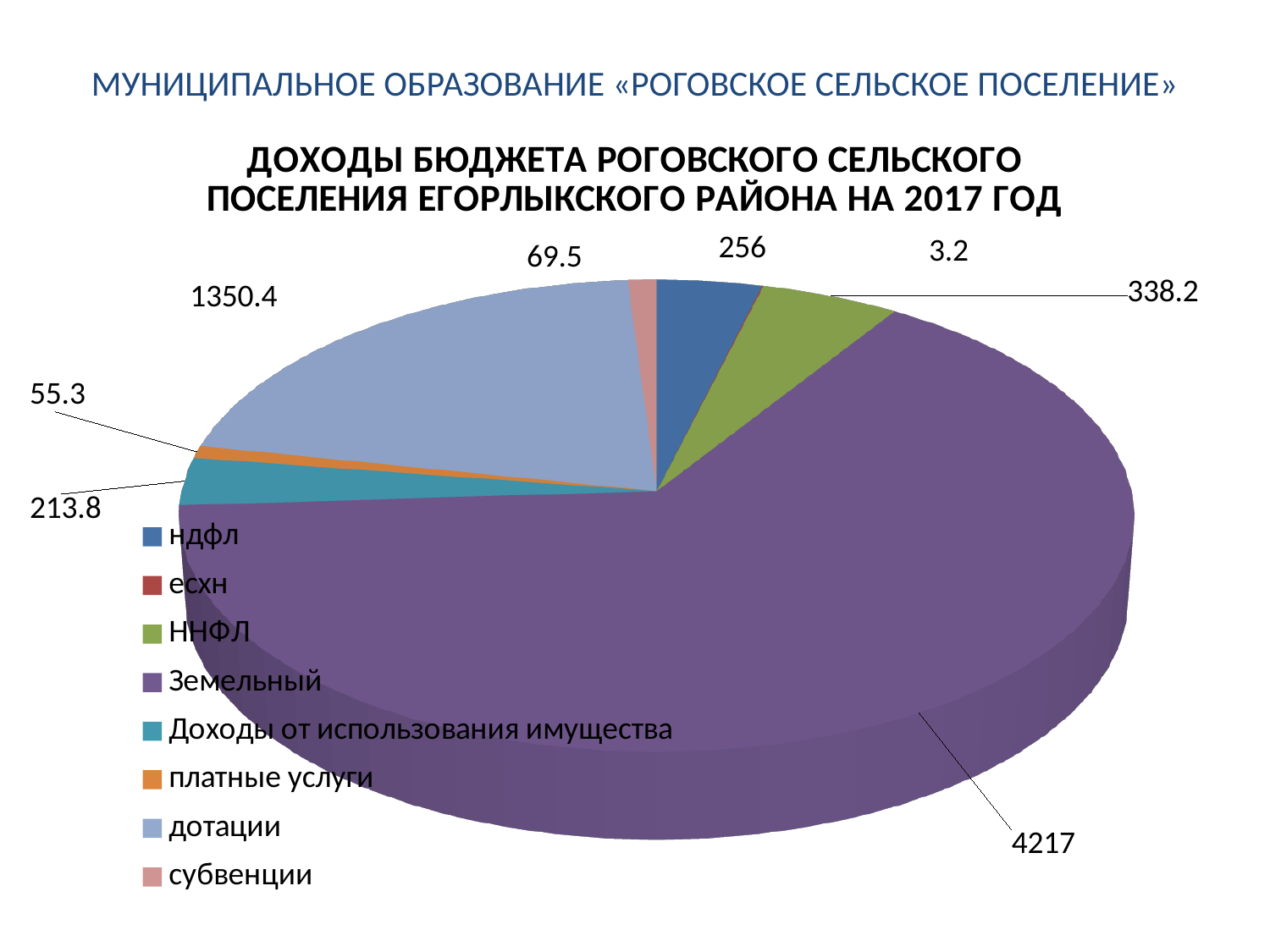
Which category has the largest slice? Земельный What is the value for Доходы от использования имущества? 213.8 What is the value for дотации? 1350.4 How many categories does the legend list? 8 What is the value for Земельный? 4217 Which is larger, the value for ННФЛ or the value for ндфл? ННФЛ What is the title of the chart? ДОХОДЫ БЮДЖЕТА РОГОВСКОГО СЕЛЬСКОГО ПОСЕЛЕНИЯ ЕГОРЛЫКСКОГО РАЙОНА НА 2017 ГОД What is the value for есхн? 3.2 What is the difference between the values for Земельный and дотации? 2866.6 What kind of chart is shown on the slide? pie chart What is the value for ндфл? 256 Which category has the smallest slice? есхн